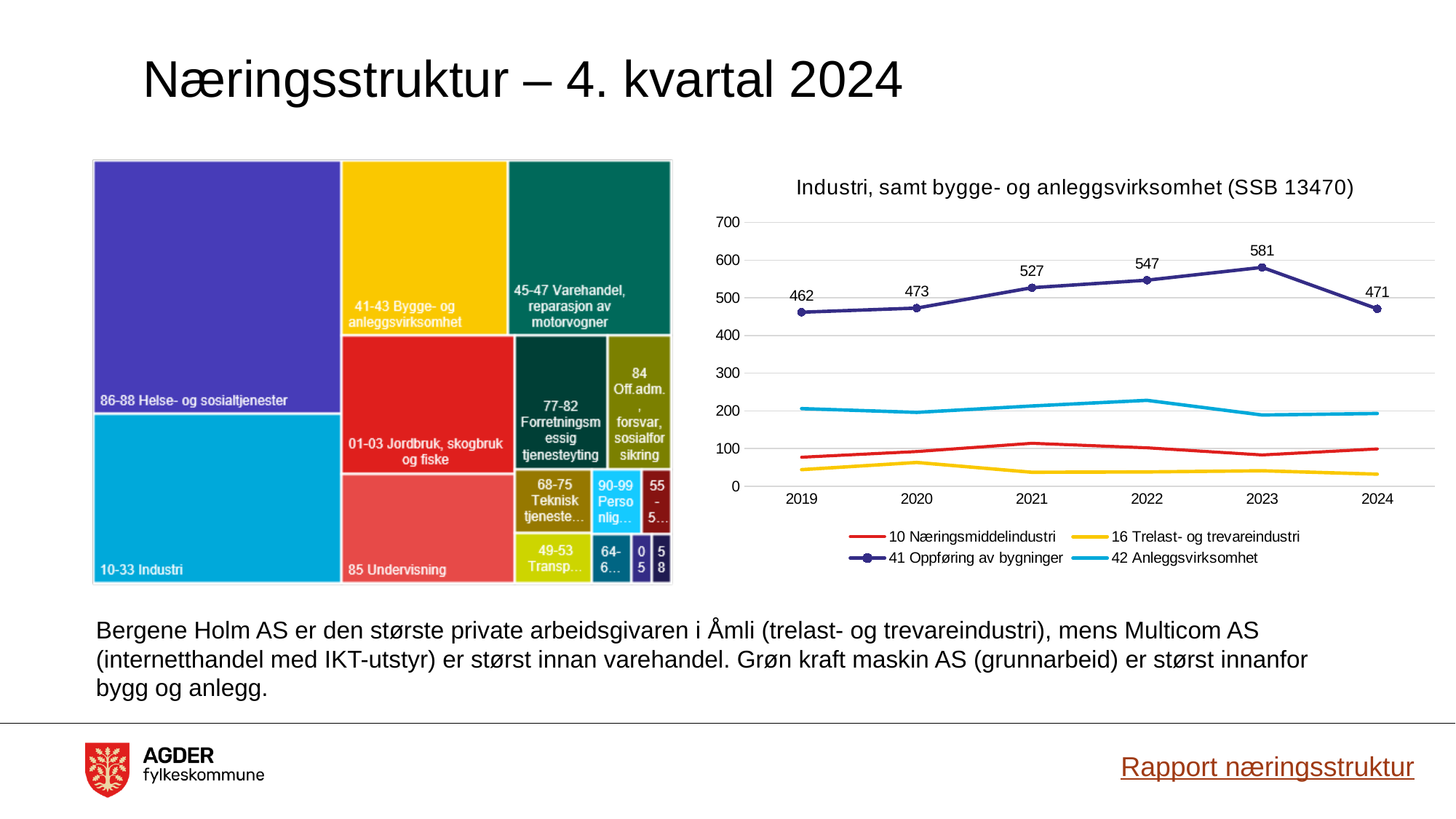
In the line chart 'Industri, samt bygge- og anleggsvirksomhet (SSB 13470)', what is the value for 41 Oppføring av bygninger in 2023? 581 In the line chart on the right, what is the difference between the 2023 and 2024 values for 41 Oppføring av bygninger? 110 In the line chart on the right, what is the value for 41 Oppføring av bygninger in 2024? 471 In the line chart on the right, is the value for 42 Anleggsvirksomhet in 2022 greater or less than 200? greater How many years are shown on the x axis of the line chart on the right? 6 In the line chart on the right, is the value for 16 Trelast- og trevareindustri in 2024 greater or less than 100? less In the line chart on the right, in which year does 41 Oppføring av bygninger reach its highest value? 2023 How many series does the legend of the line chart on the right list? 4 In the line chart on the right, in which year is the value for 41 Oppføring av bygninger lowest? 2019 In the line chart on the right, which is larger for 41 Oppføring av bygninger: the value in 2021 or in 2022? 2022 What kind of chart is the chart on the right of the slide? Line chart In the line chart on the right, what is the value for 41 Oppføring av bygninger in 2019? 462